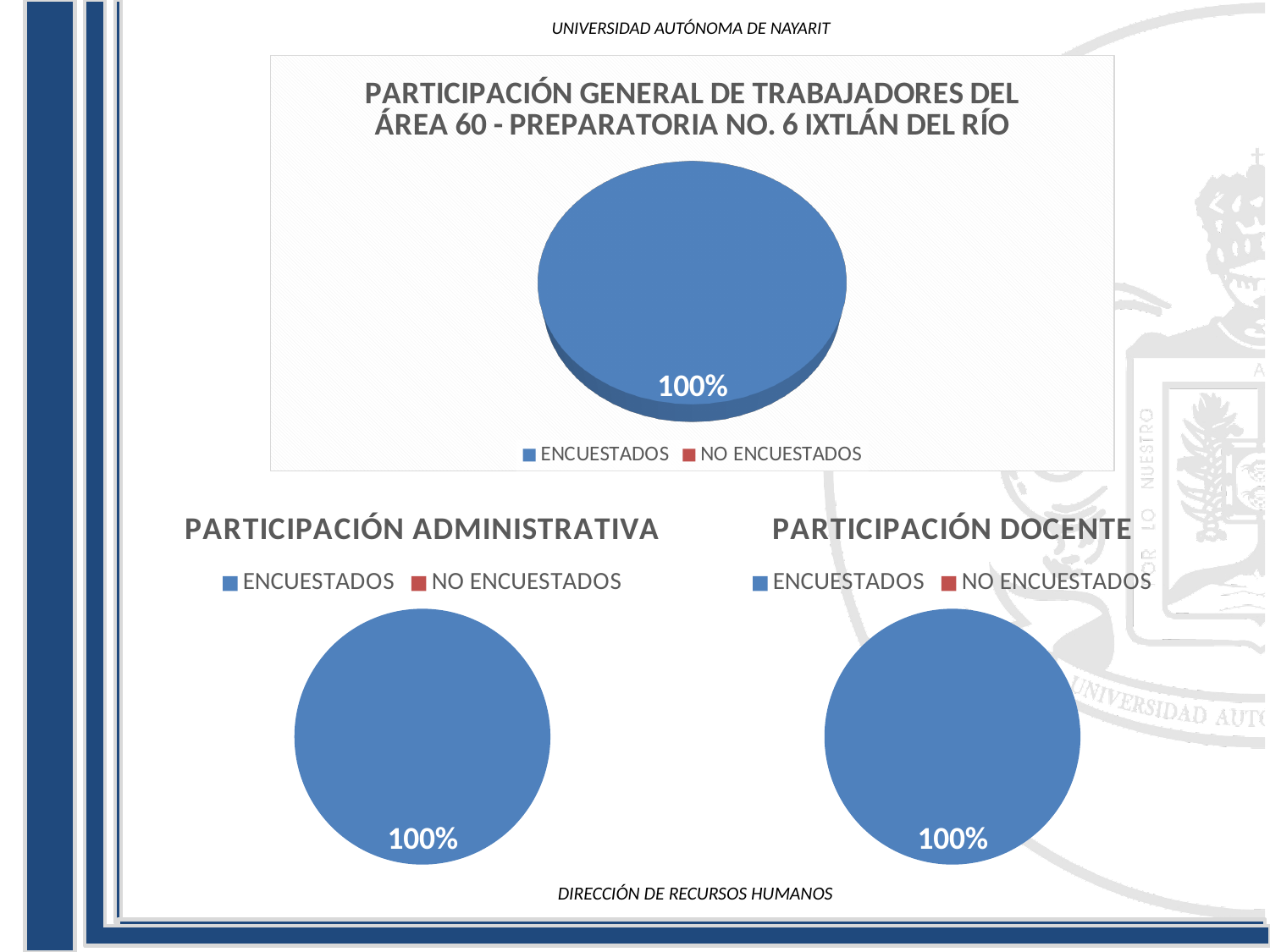
In the 'PARTICIPACIÓN DOCENTE' chart, which category is the largest? ENCUESTADOS What colour represents NO ENCUESTADOS in the legends on the slide? Red In the chart titled 'PARTICIPACIÓN GENERAL DE TRABAJADORES DEL ÁREA 60 - PREPARATORIA NO. 6 IXTLÁN DEL RÍO', what share of the pie is labelled? 100% How many series does the legend of the top chart list? 2 In the top chart, which legend entry does the single visible slice correspond to? ENCUESTADOS In the chart titled 'PARTICIPACIÓN ADMINISTRATIVA', what percentage is printed on the pie? 100% In the 'PARTICIPACIÓN ADMINISTRATIVA' chart, which category is the largest? ENCUESTADOS What kind of chart is the 'PARTICIPACIÓN DOCENTE' chart? Pie chart How many pie charts are shown on the slide? 3 In the chart titled 'PARTICIPACIÓN DOCENTE', what percentage is printed on the pie? 100% How many entries does the legend of the 'PARTICIPACIÓN ADMINISTRATIVA' chart list? 2 What kind of chart is the top chart on the slide? Pie chart